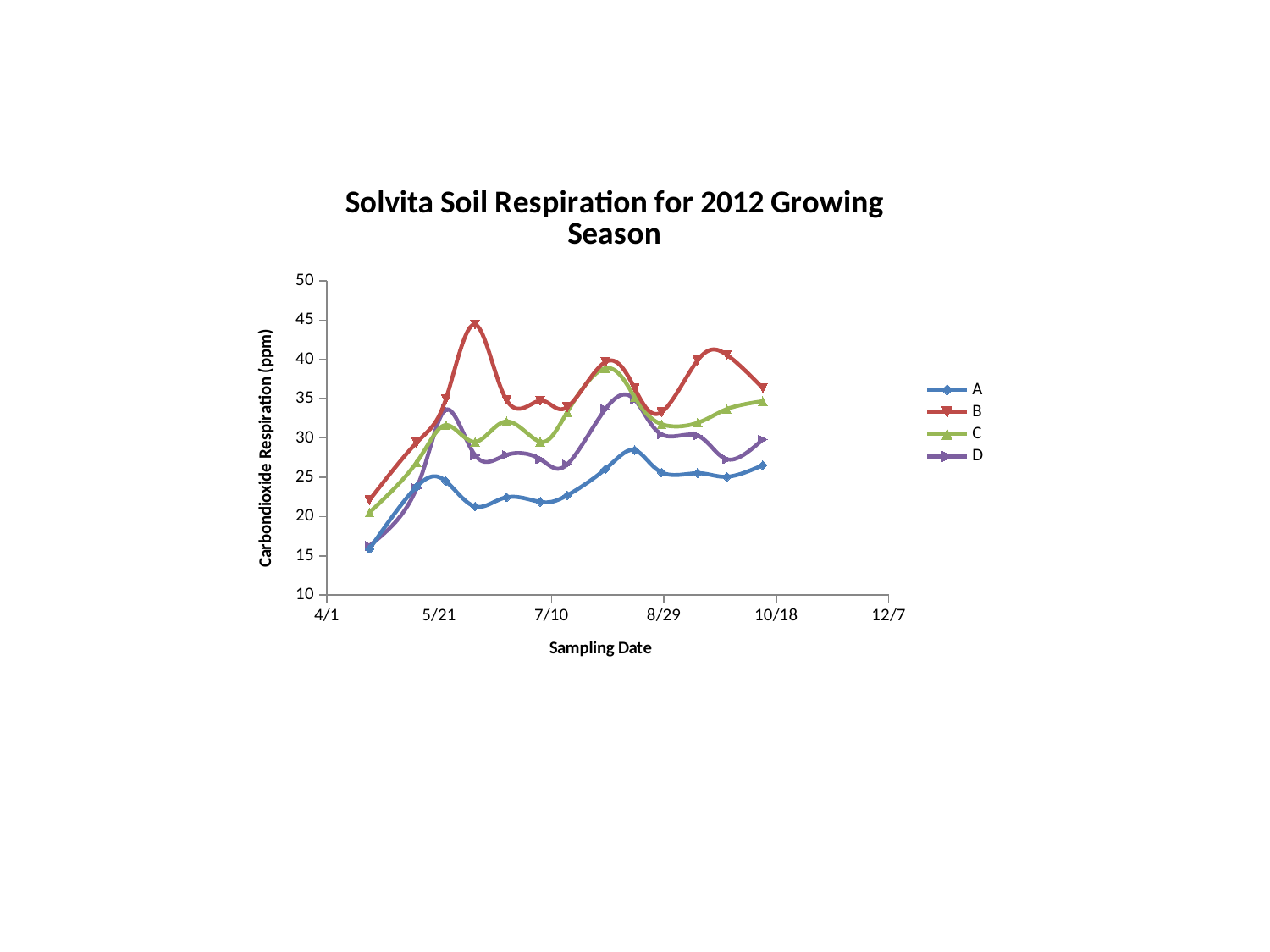
Do the values for series A rise or fall from the first sampling date to the last? rise Is the first value for series A greater or less than 20? less Which series reaches the highest value on the chart? B Which series has the lowest values across the season? A What is the title of the chart? Solvita Soil Respiration for 2012 Growing Season What is the label of the vertical axis? Carbondioxide Respiration (ppm) What kind of chart is shown on the slide? line chart Is the last value for series B greater or less than 30? greater Which series is larger at the 5/21 sampling date, A or B? B Is the highest value for series A greater or less than 30? less How many series does the legend list? 4